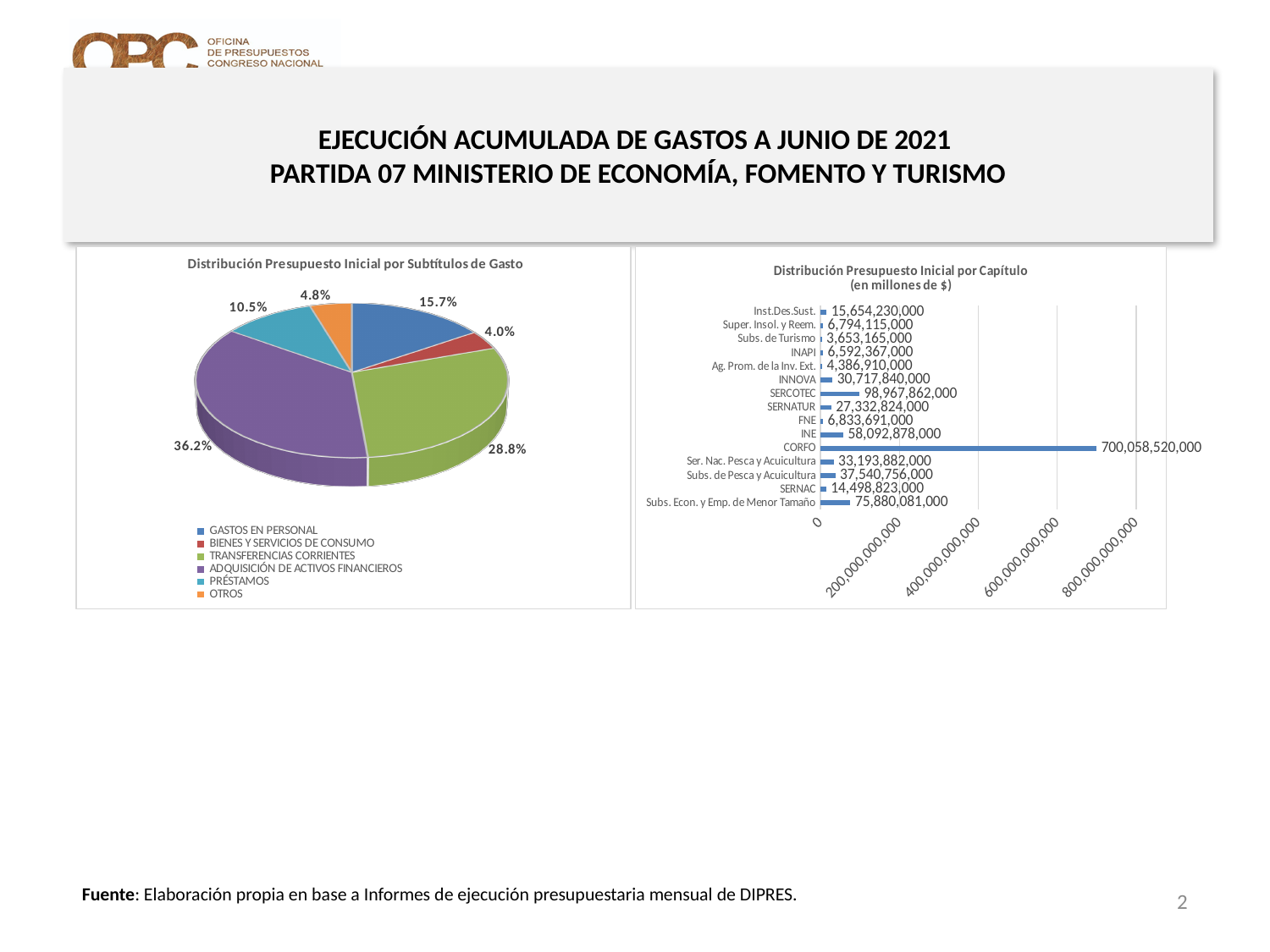
In the chart 'Distribución Presupuesto Inicial por Capítulo', which capítulo has the lowest value? Subs. de Turismo How many capítulos are shown in the chart 'Distribución Presupuesto Inicial por Capítulo'? 15 In the chart 'Distribución Presupuesto Inicial por Capítulo', what is the value for CORFO? 700,058,520,000 In the chart 'Distribución Presupuesto Inicial por Capítulo', what is the value for SERCOTEC? 98,967,862,000 What kind of chart is 'Distribución Presupuesto Inicial por Capítulo'? Bar chart In the chart 'Distribución Presupuesto Inicial por Capítulo', which is larger, the value for SERNATUR or the value for Ser. Nac. Pesca y Acuicultura? Ser. Nac. Pesca y Acuicultura In the chart 'Distribución Presupuesto Inicial por Capítulo', is the value for CORFO greater or less than 600,000,000,000? greater In the chart 'Distribución Presupuesto Inicial por Capítulo', what is the difference between the values for INE and INNOVA? 27,375,038,000 In the pie chart 'Distribución Presupuesto Inicial por Subtítulos de Gasto', what share does ADQUISICIÓN DE ACTIVOS FINANCIEROS have? 36.2% In the chart 'Distribución Presupuesto Inicial por Capítulo', which capítulo has the highest value? CORFO How many categories does the legend of the pie chart 'Distribución Presupuesto Inicial por Subtítulos de Gasto' list? 6 In the pie chart 'Distribución Presupuesto Inicial por Subtítulos de Gasto', what share does GASTOS EN PERSONAL have? 15.7%